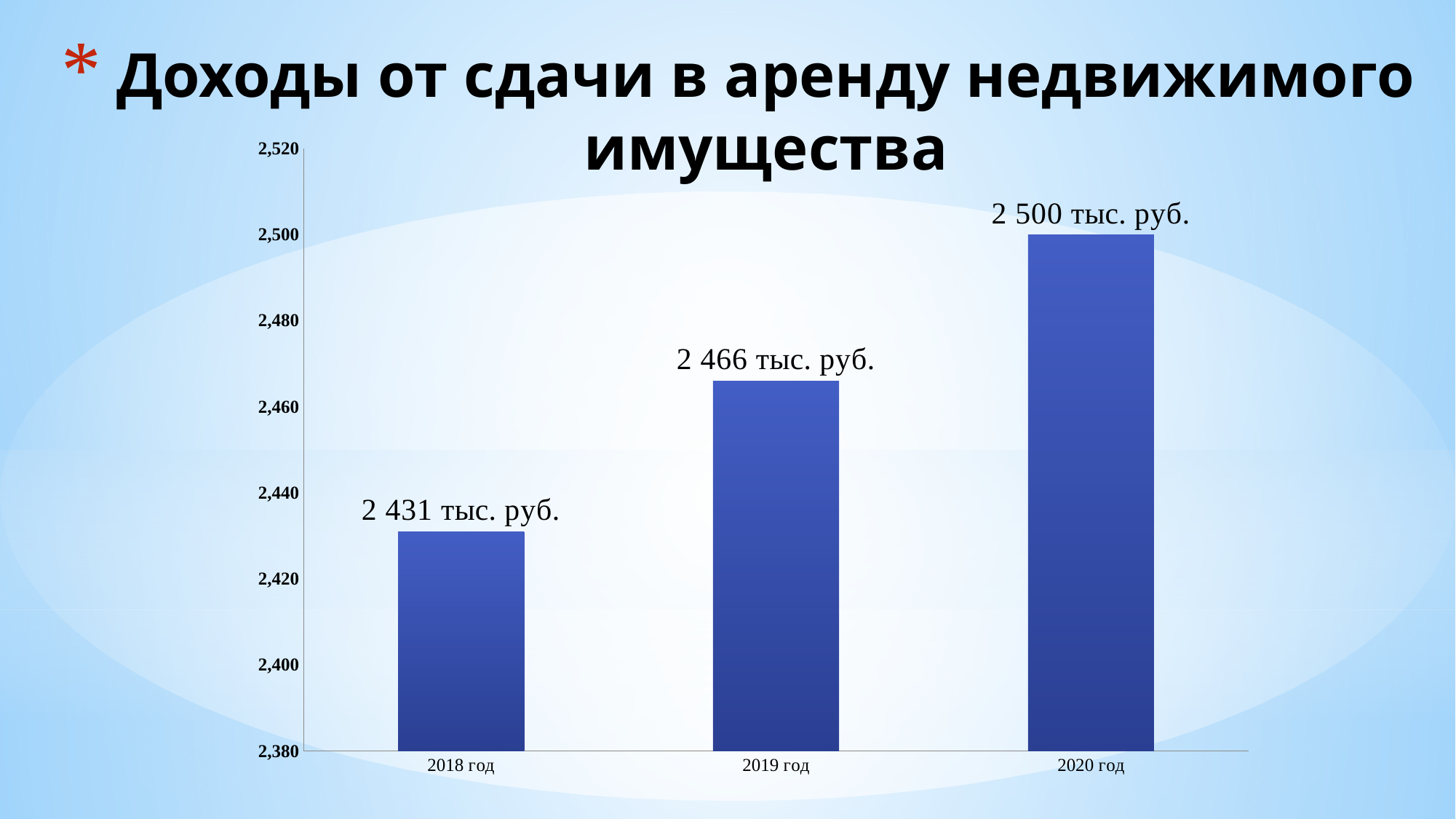
What is the value for 2020 год? 2 500 тыс. руб. What is the difference between the values for 2020 год and 2018 год? 69 тыс. руб. What is the difference between the values for 2019 год and 2018 год? 35 тыс. руб. How many years are shown on the chart? 3 What is the value for 2019 год? 2 466 тыс. руб. Is the value for 2019 год greater or less than 2,480? less Which year has the lowest value? 2018 год Do the values rise or fall from 2018 год to 2020 год? rise What kind of chart is shown on the slide? bar chart Which is larger, the value for 2019 год or the value for 2018 год? 2019 год What is the value for 2018 год? 2 431 тыс. руб. Which year has the highest value? 2020 год